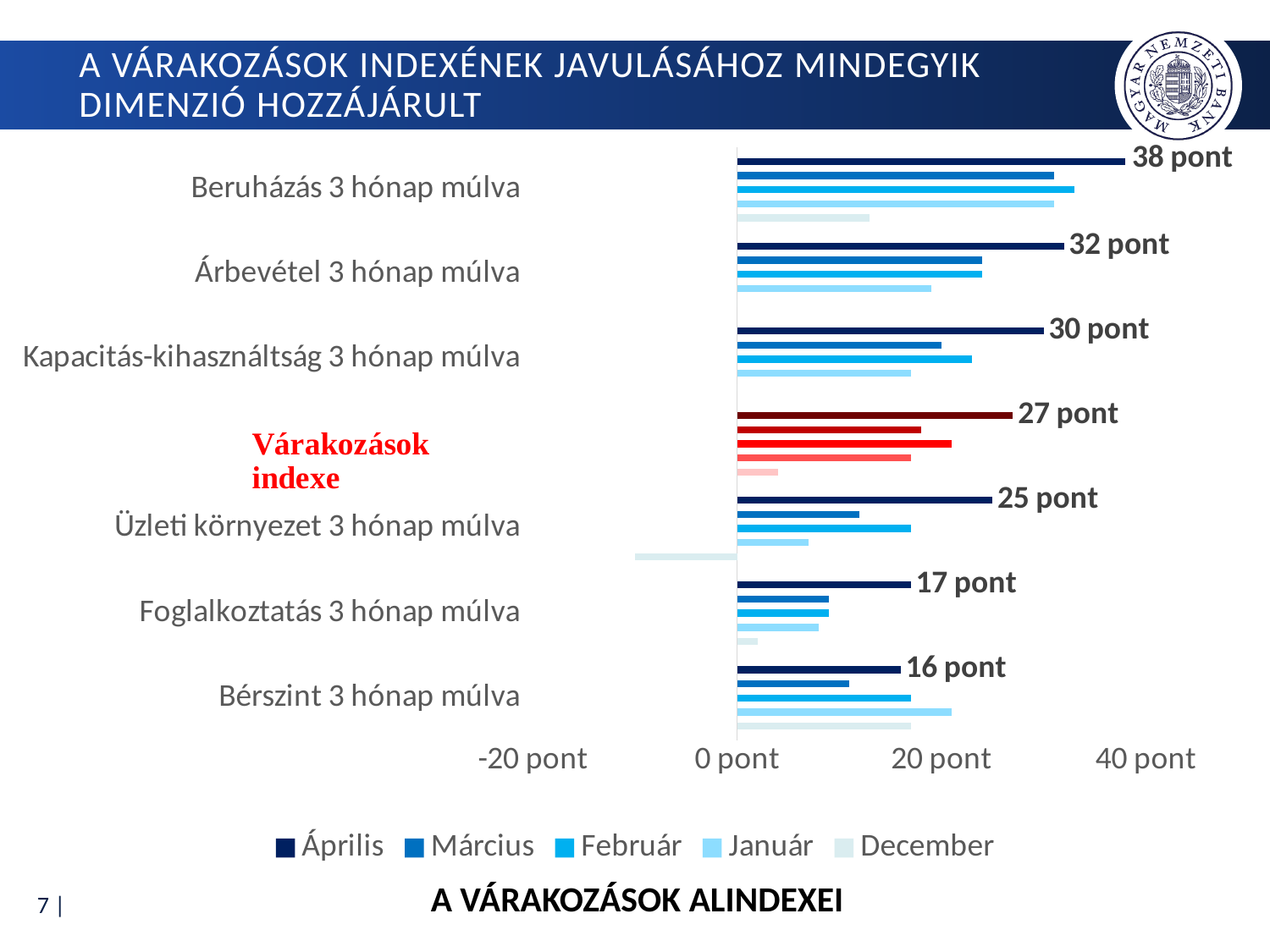
Is the Február value for Beruházás 3 hónap múlva greater or less than 20 pont? greater How many series does the legend list? 5 Is the December value for Üzleti környezet 3 hónap múlva greater or less than 0 pont? less Which has the larger Április value, Árbevétel 3 hónap múlva or Kapacitás-kihasználtság 3 hónap múlva? Árbevétel 3 hónap múlva What is the Április value for Várakozások indexe? 27 pont How many categories are shown on the chart? 7 What is the Április value for Beruházás 3 hónap múlva? 38 pont What kind of chart is shown on the slide? bar chart What is the difference between the Április values for Beruházás 3 hónap múlva and Bérszint 3 hónap múlva? 22 pont What is the title of the chart? A VÁRAKOZÁSOK ALINDEXEI Which category has the lowest Április value? Bérszint 3 hónap múlva Which category has the highest Április value? Beruházás 3 hónap múlva